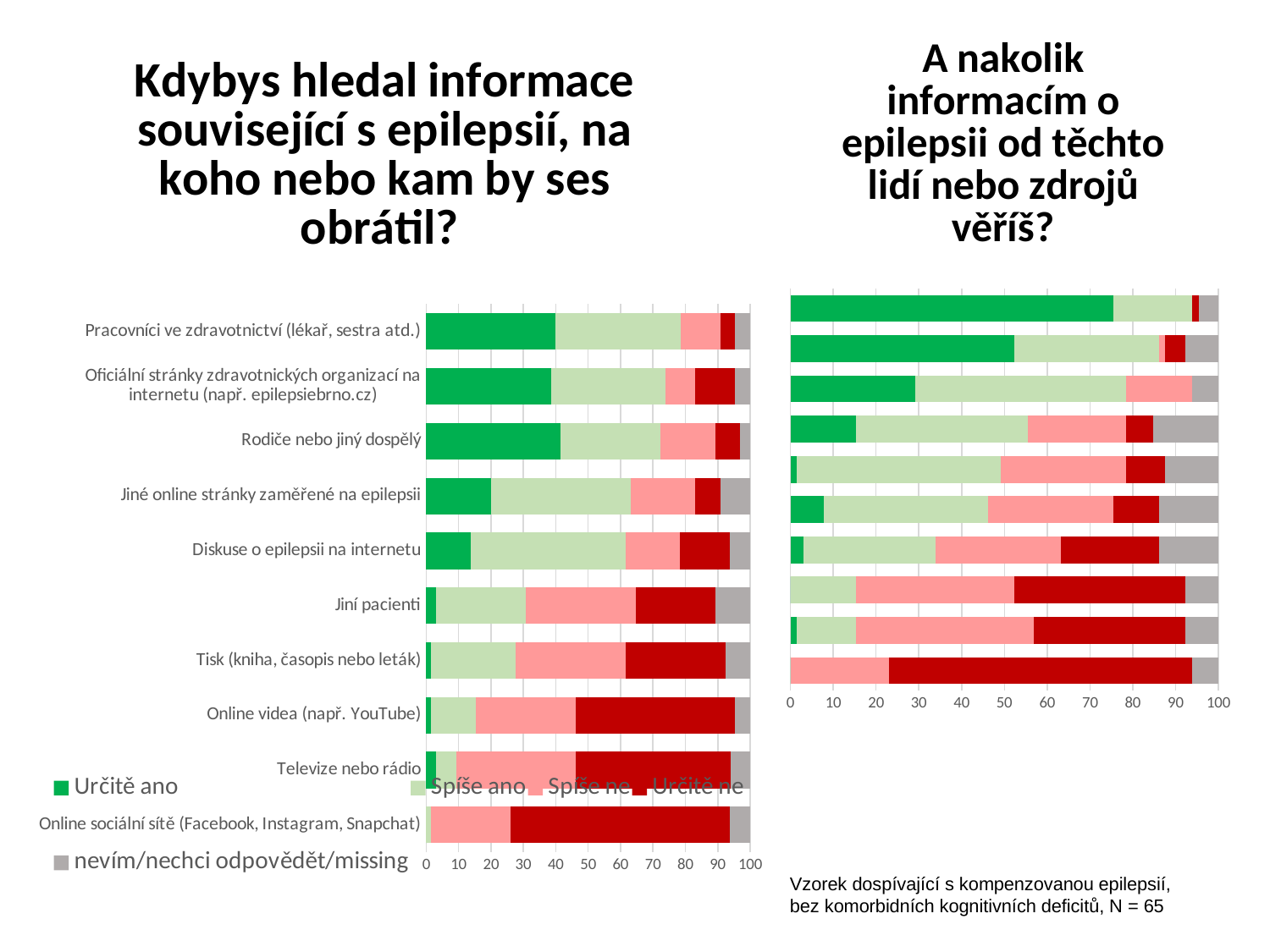
In the left chart, is the "Určitě ano" value for "Jiní pacienti" greater or less than 10? less In the left chart, is the "Určitě ano" value for "Pracovníci ve zdravotnictví (lékař, sestra atd.)" greater or less than 30? greater How many series does the legend on the slide list? 5 How many categories are listed on the left chart "Kdybys hledal informace související s epilepsií, na koho nebo kam by ses obrátil?"? 10 Which legend entry is shown in dark red? Určitě ne What kind of chart is the left chart titled "Kdybys hledal informace související s epilepsií, na koho nebo kam by ses obrátil?"? Stacked bar chart In the left chart, is the "Určitě ano" value for "Diskuse o epilepsii na internetu" greater or less than 20? less In the left chart, which category has the largest "Určitě ne" segment? Online sociální sítě (Facebook, Instagram, Snapchat) What is the title of the right chart on the slide? A nakolik informacím o epilepsii od těchto lidí nebo zdrojů věříš? In the left chart, which has the larger "Určitě ano" value: "Pracovníci ve zdravotnictví (lékař, sestra atd.)" or "Jiní pacienti"? Pracovníci ve zdravotnictví (lékař, sestra atd.)